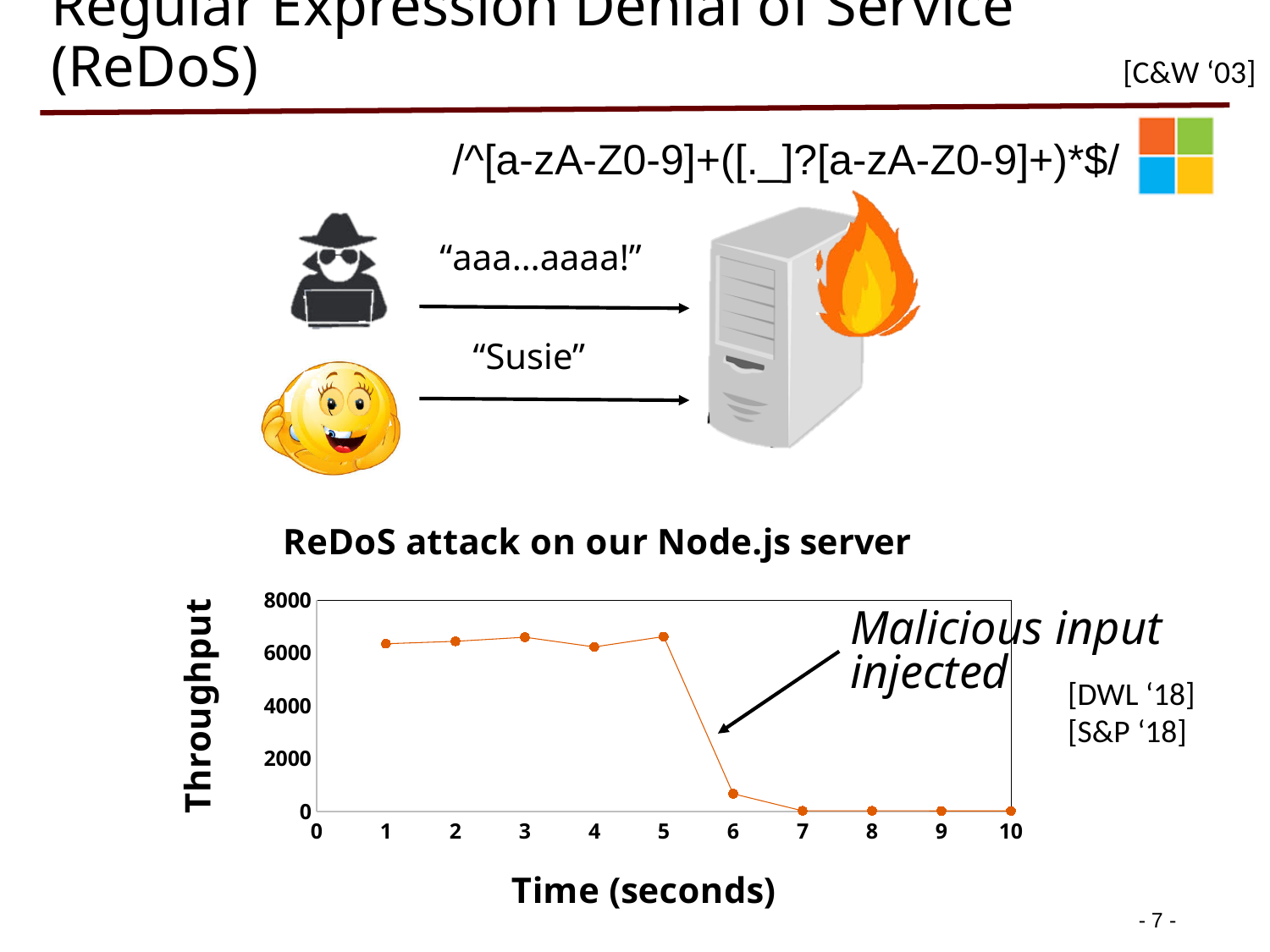
What kind of chart is shown on the slide? line chart Is the throughput at 3 seconds greater or less than 6000? greater Does the throughput rise or fall between 5 seconds and 7 seconds? fall What is the title of the chart? ReDoS attack on our Node.js server Is the throughput at 6 seconds greater or less than 2000? less How many data points are plotted on the line? 10 Is the throughput at 8 seconds greater or less than 2000? less What is the label of the x axis of the chart? Time (seconds) Overall, does the throughput rise or fall as time increases from 1 to 10 seconds? fall Which has the higher throughput, 5 seconds or 6 seconds? 5 seconds Which has the higher throughput, 2 seconds or 7 seconds? 2 seconds